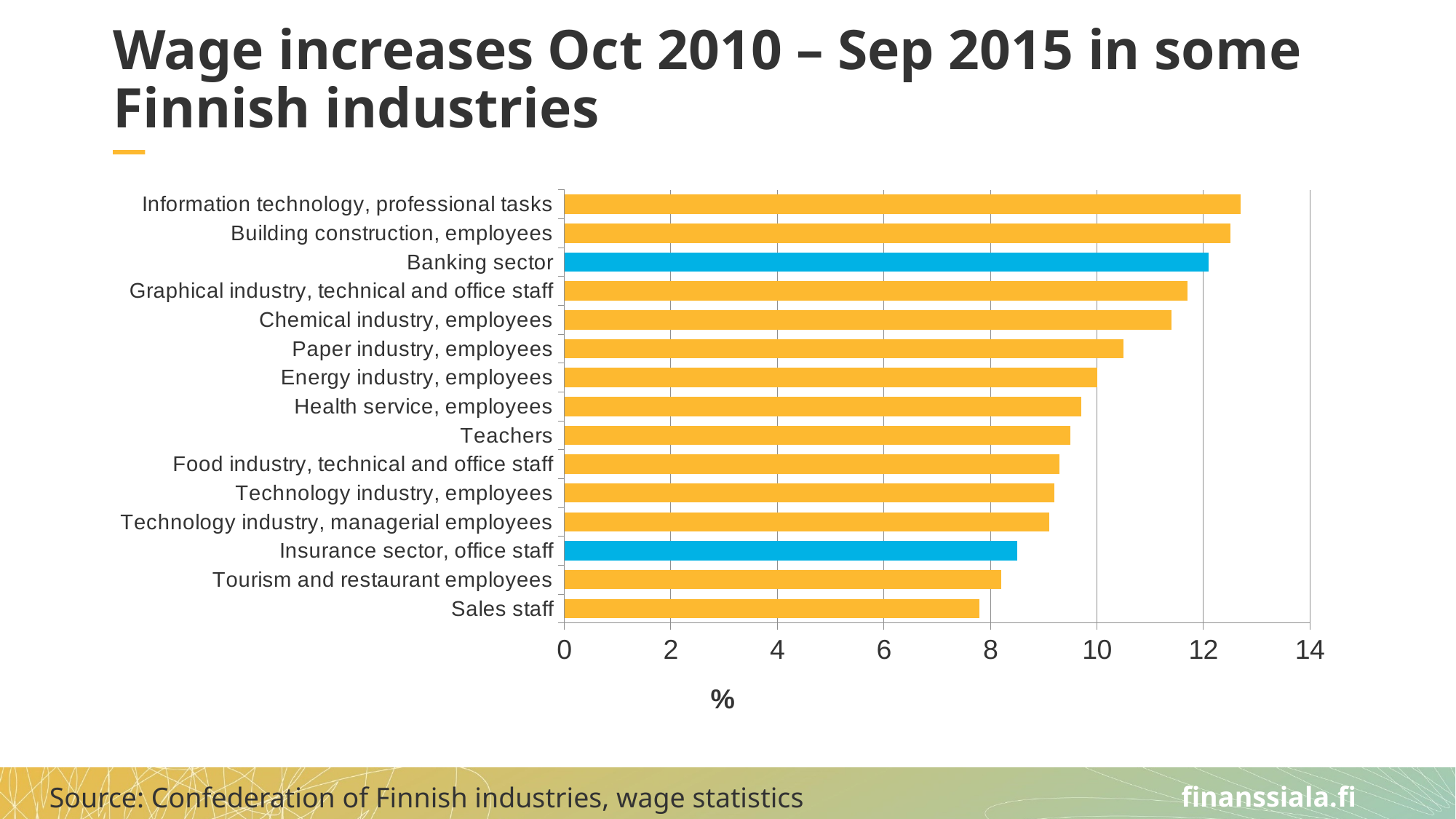
Is the value for Paper industry, employees greater or less than 10? greater What kind of chart is shown on the slide? bar chart Which has the larger wage increase, Building construction, employees or Banking sector? Building construction, employees Which has the larger wage increase, Banking sector or Insurance sector, office staff? Banking sector Is the value for Chemical industry, employees greater or less than 12? less Is the value for Teachers greater or less than 10? less Do the bar values rise or fall going from the top of the chart to the bottom? fall Which group has the lowest wage increase on the chart? Sales staff How many industries or groups are listed on the chart? 15 Which two bars are coloured blue instead of yellow? Banking sector and Insurance sector, office staff